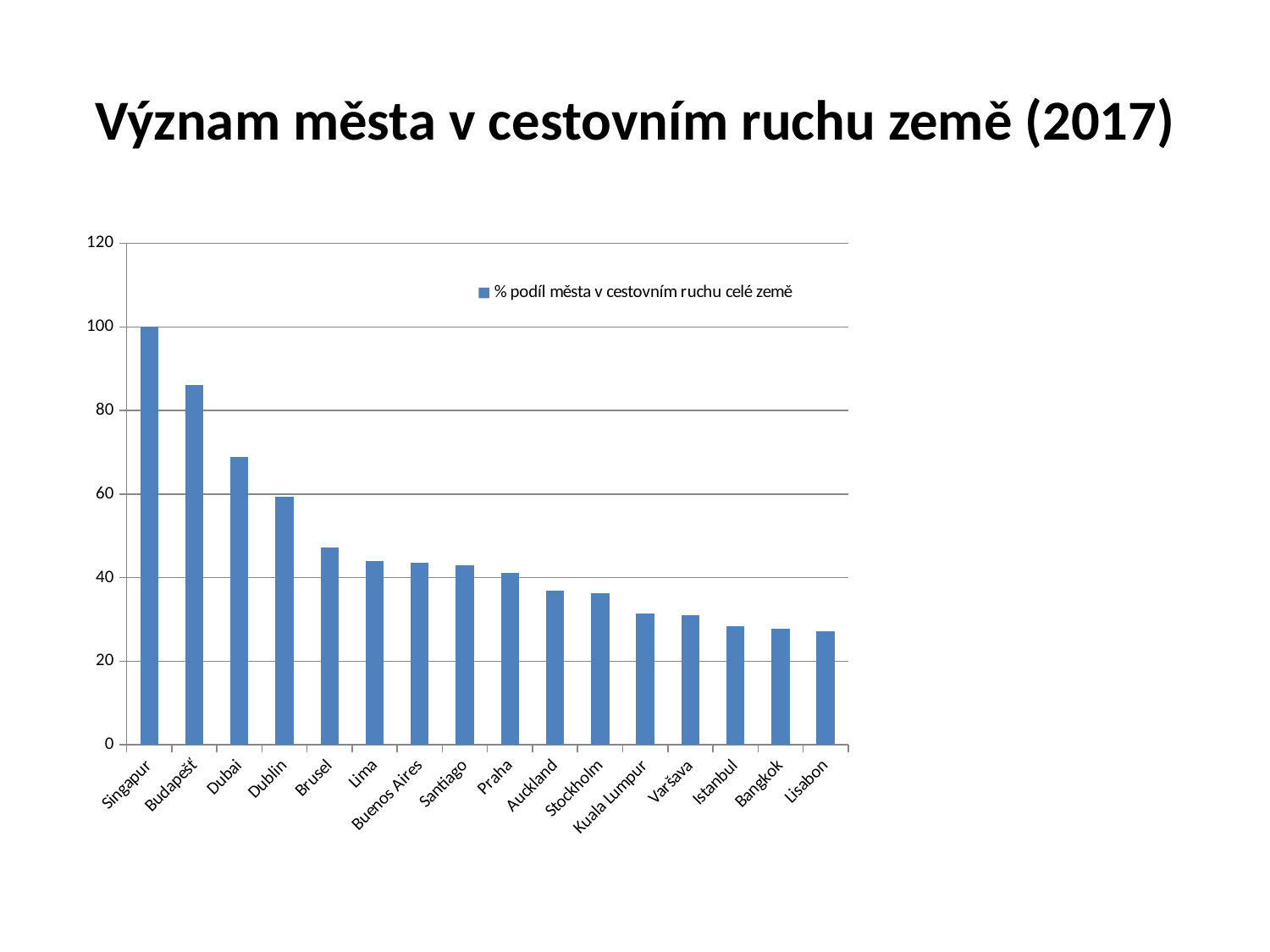
Is the value for Budapešť greater or less than 80? greater Is the value for Auckland greater or less than 40? less Is the value for Lisabon greater or less than 20? greater Do the values rise or fall from left to right along the x axis? fall Which city has the highest value in the chart? Singapur What is the value for Singapur? 100 Which has a larger value, Dubai or Dublin? Dubai What kind of chart is shown on the slide? bar chart How many cities are shown on the x axis of the chart? 16 What is the title of the slide? Význam města v cestovním ruchu země (2017) How many series does the chart legend list? 1